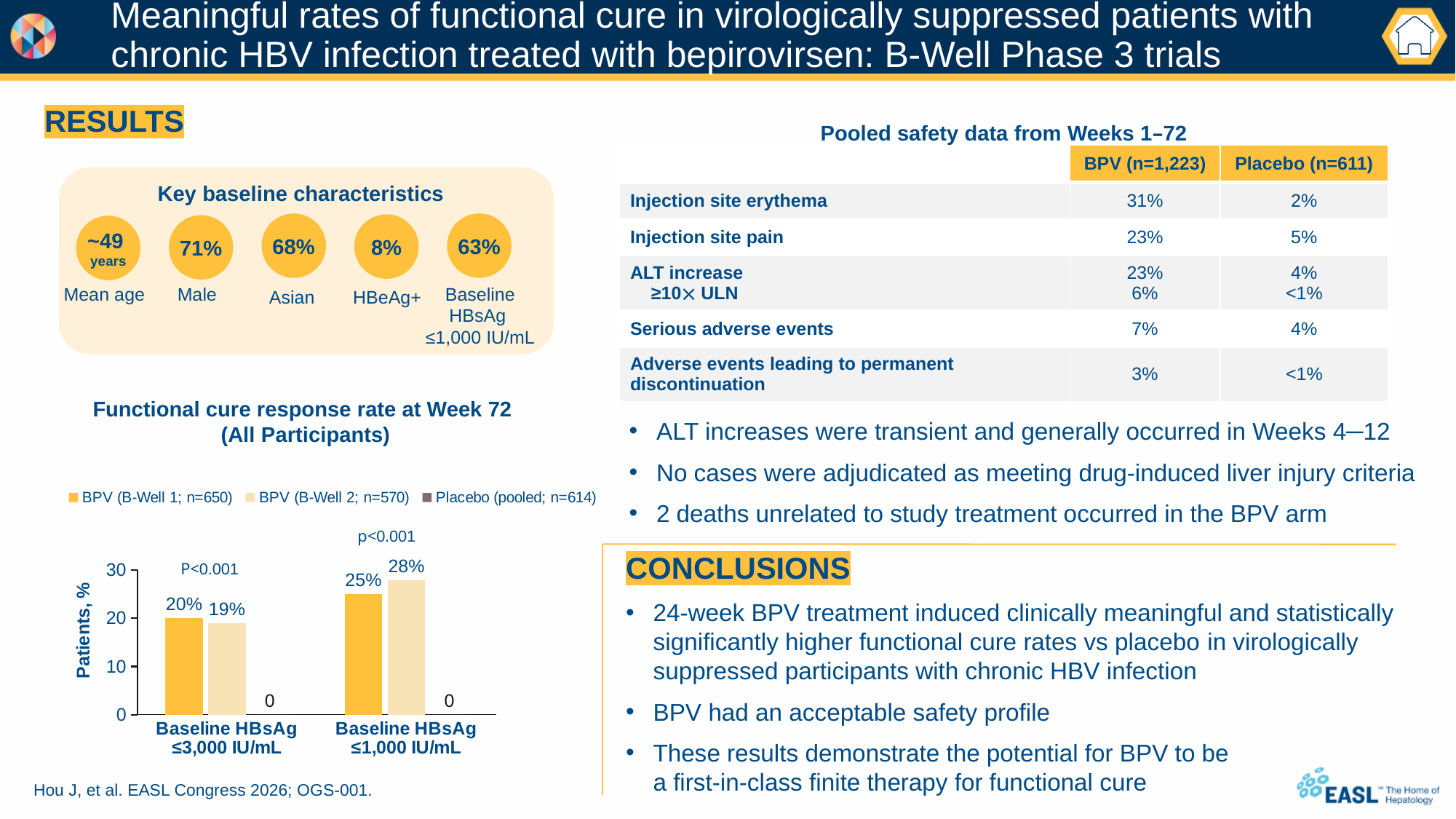
What is the y-axis label of the functional cure response rate chart? Patients, % What kind of chart is used to show the functional cure response rate at Week 72? Bar chart What is the functional cure response rate for Placebo (pooled; n=614) in the Baseline HBsAg ≤3,000 IU/mL group? 0 How many series does the legend of the functional cure response rate chart list? 3 Which series has the highest functional cure response rate in the Baseline HBsAg ≤1,000 IU/mL group? BPV (B-Well 2; n=570) How many baseline HBsAg categories are shown on the x axis of the functional cure response rate chart? 2 What is the difference between the BPV (B-Well 2; n=570) and BPV (B-Well 1; n=650) response rates in the Baseline HBsAg ≤1,000 IU/mL group? 3% Which series has the lowest functional cure response rate in the Baseline HBsAg ≤3,000 IU/mL group? Placebo (pooled; n=614) What is the functional cure response rate for BPV (B-Well 2; n=570) in the Baseline HBsAg ≤3,000 IU/mL group? 19% What is the functional cure response rate for BPV (B-Well 2; n=570) in the Baseline HBsAg ≤1,000 IU/mL group? 28% What is the functional cure response rate for BPV (B-Well 1; n=650) in the Baseline HBsAg ≤3,000 IU/mL group? 20% Is the BPV (B-Well 1; n=650) response rate higher in the Baseline HBsAg ≤3,000 IU/mL group or the Baseline HBsAg ≤1,000 IU/mL group? Baseline HBsAg ≤1,000 IU/mL